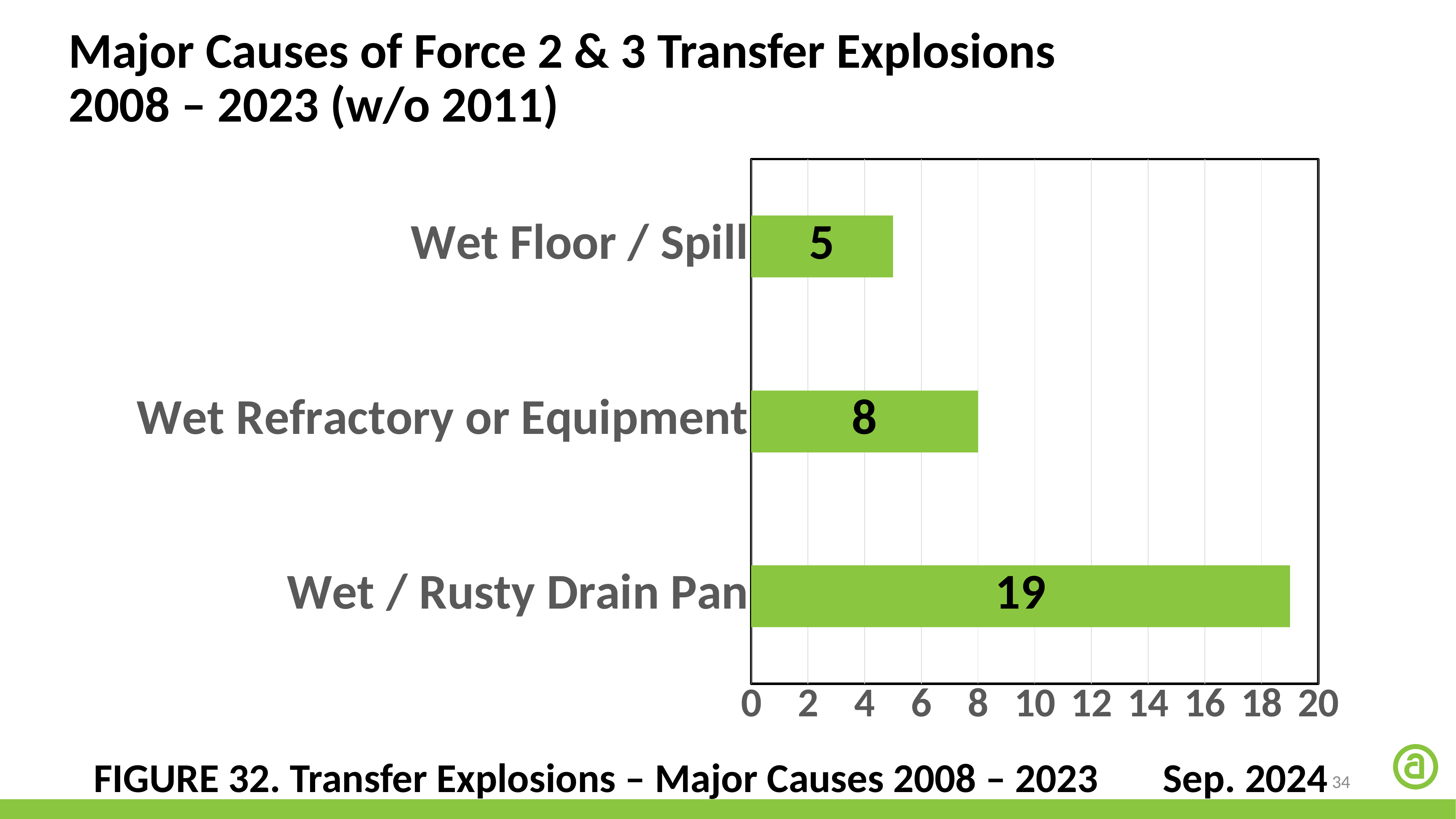
What kind of chart is shown on the slide? bar chart Is the value for Wet / Rusty Drain Pan greater or less than 10? greater What is the difference between the values for Wet / Rusty Drain Pan and Wet Refractory or Equipment? 11 What is the value for Wet Floor / Spill? 5 Which cause has the lowest value? Wet Floor / Spill What is the value for Wet / Rusty Drain Pan? 19 What is the difference between the values for Wet Refractory or Equipment and Wet Floor / Spill? 3 Which cause has the highest value? Wet / Rusty Drain Pan How many causes are shown in the chart? 3 What is the maximum value shown on the horizontal axis? 20 What is the value for Wet Refractory or Equipment? 8 Which is larger, the value for Wet Refractory or Equipment or the value for Wet Floor / Spill? Wet Refractory or Equipment